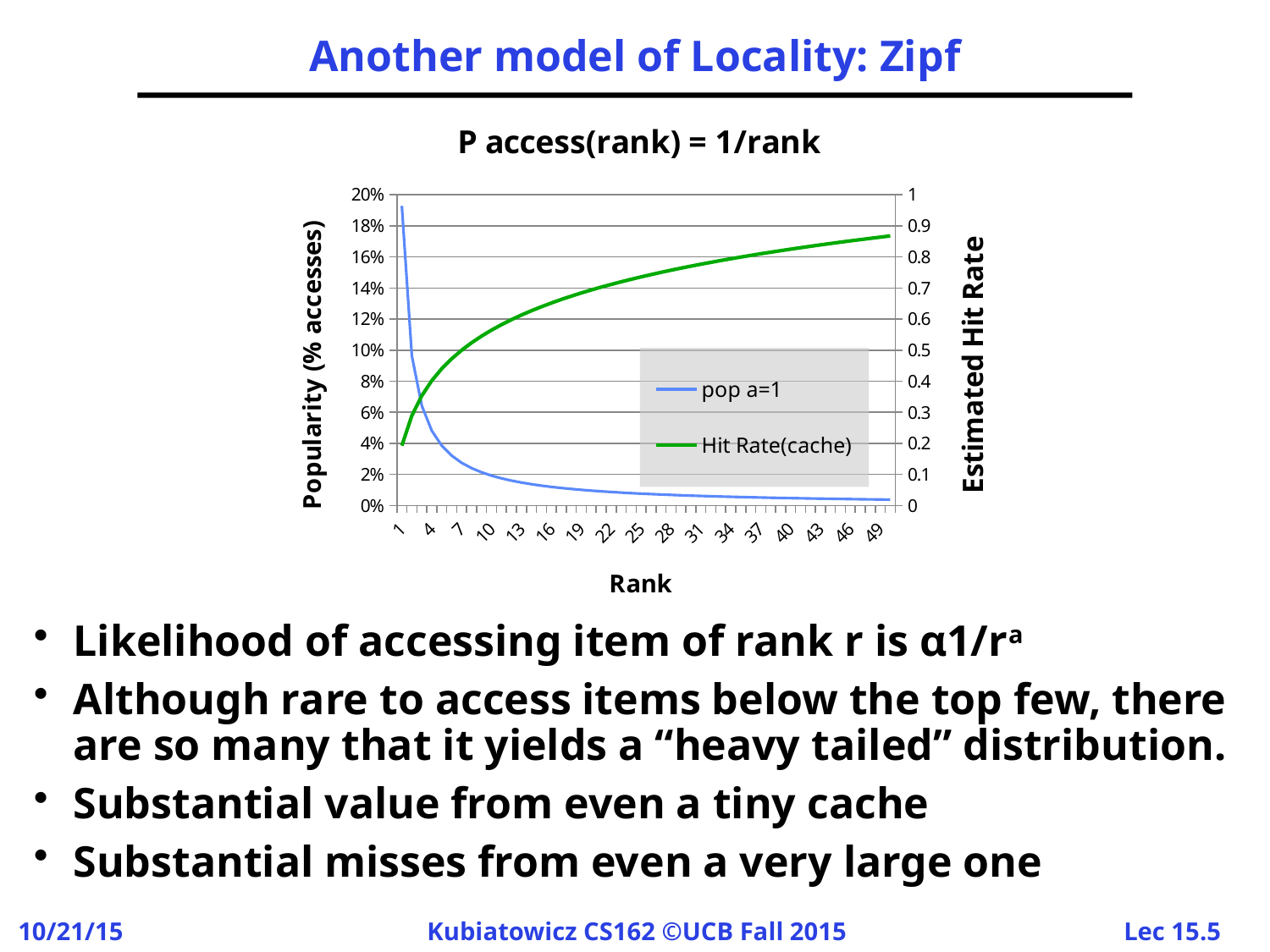
What is the title of the chart? P access(rank) = 1/rank Is the 'pop a=1' value at rank 1 greater or less than 18%? greater Is the 'Hit Rate(cache)' value at rank 49 greater or less than 0.8? greater What is the highest rank label shown on the x axis of the chart? 49 What are the two series named in the chart legend? pop a=1 and Hit Rate(cache) How many series does the chart legend list? 2 Does the 'pop a=1' series rise or fall as rank increases along the x axis? fall Is the 'pop a=1' value at rank 4 greater or less than 10%? less What kind of chart is shown on the slide? line chart Does the 'Hit Rate(cache)' series rise or fall as rank increases along the x axis? rise